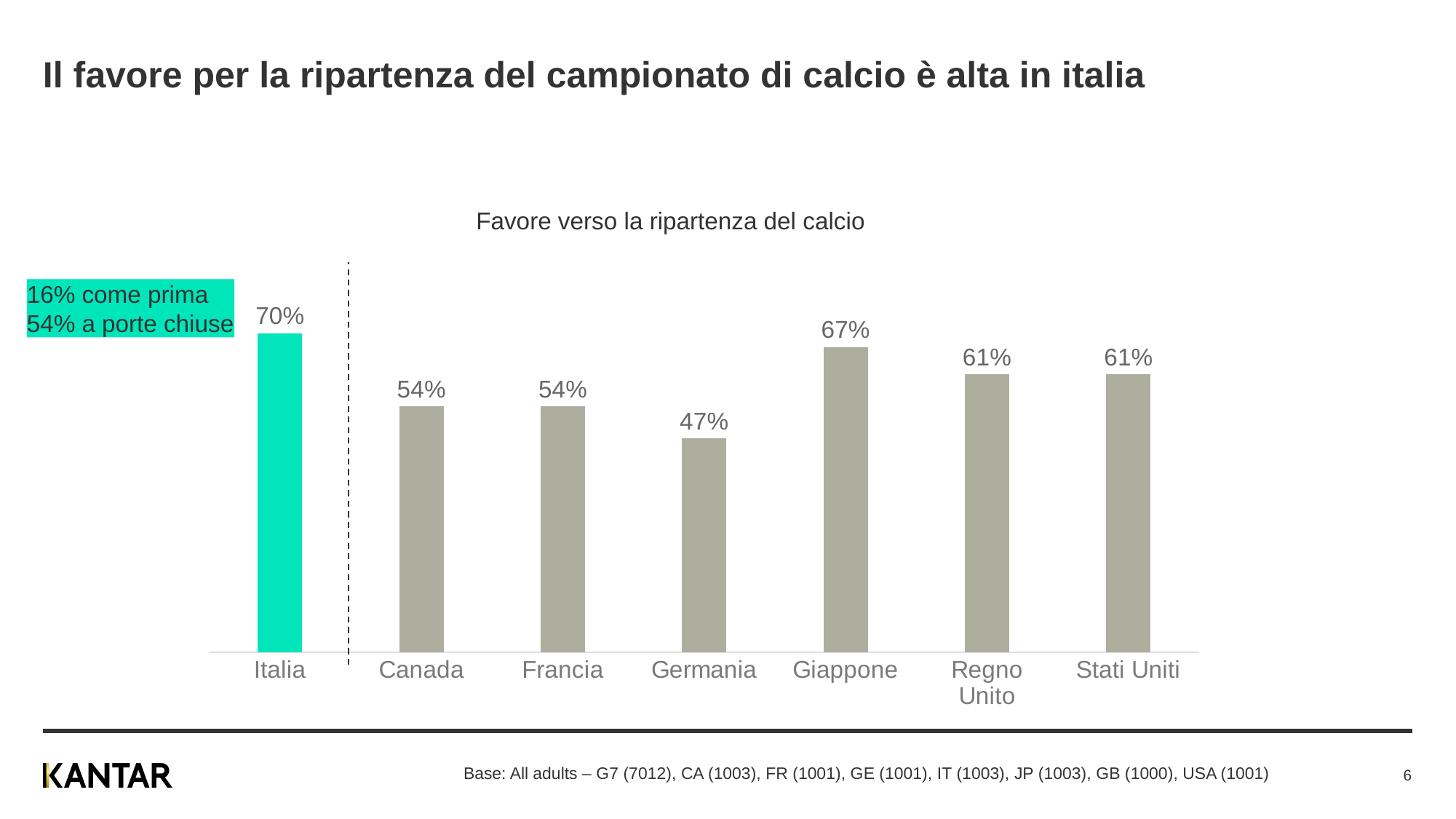
What is the value for Giappone? 67% What is the value for Regno Unito? 61% What is the title of the chart? Favore verso la ripartenza del calcio Which is larger, the value for Giappone or the value for Stati Uniti? Giappone Which country has the highest value? Italia What kind of chart is shown on the slide? Bar chart What is the value for Italia? 70% Which country has the lowest value? Germania How many countries are shown in the chart? 7 What is the difference between the values for Italia and Germania? 23% What is the value for Germania? 47% What is the difference between the values for Giappone and Canada? 13%